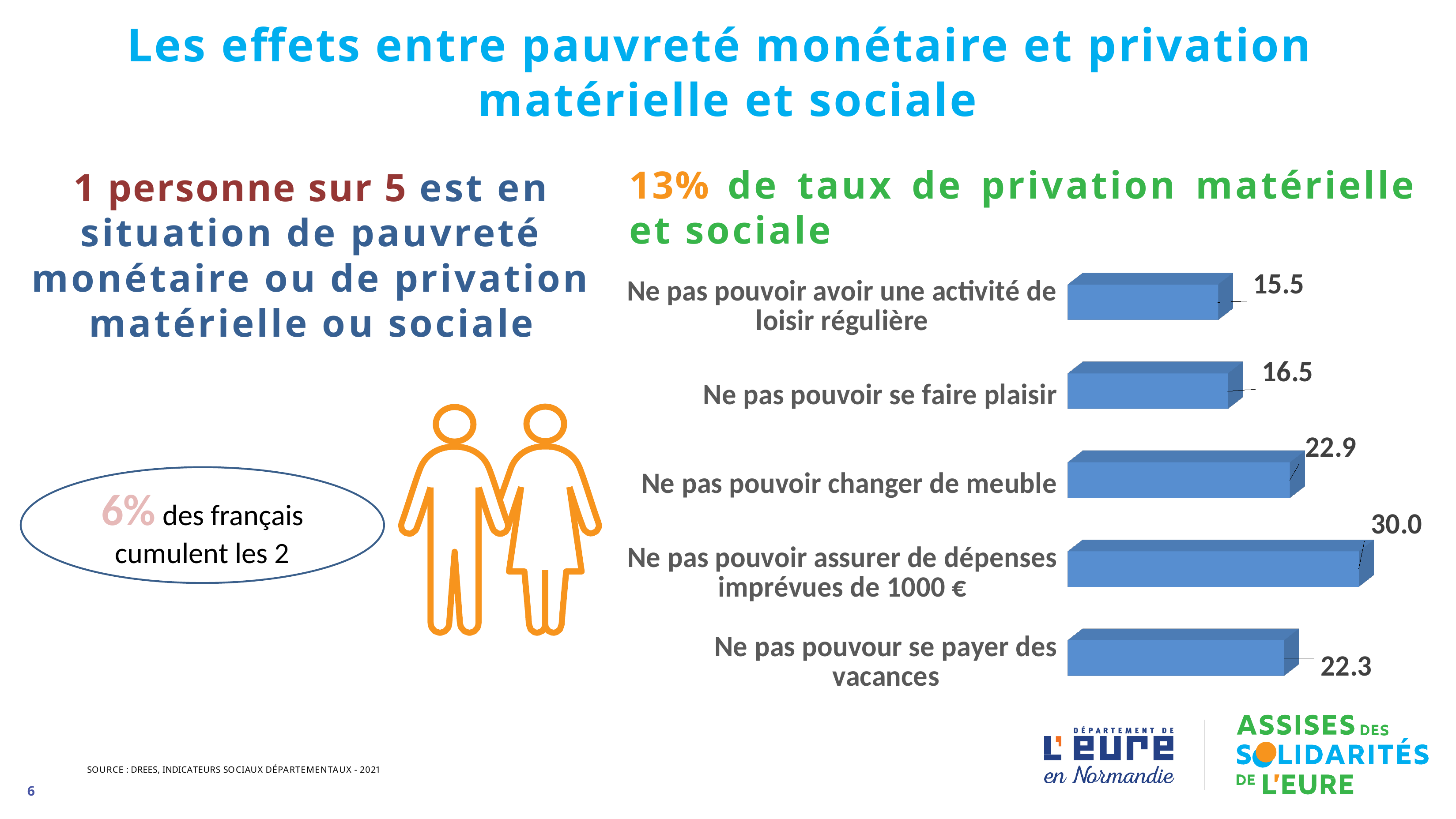
What is the value for "Ne pas pouvoir assurer de dépenses imprévues de 1000 €"? 30.0 Which is larger: the value for "Ne pas pouvoir changer de meuble" or for "Ne pas pouvour se payer des vacances"? Ne pas pouvoir changer de meuble Which category has the highest value? Ne pas pouvoir assurer de dépenses imprévues de 1000 € How many categories does the bar chart show? 5 What is the value for "Ne pas pouvoir changer de meuble"? 22.9 Which category has the lowest value? Ne pas pouvoir avoir une activité de loisir régulière What is the value for "Ne pas pouvoir avoir une activité de loisir régulière"? 15.5 What is the difference between the values for "Ne pas pouvoir assurer de dépenses imprévues de 1000 €" and "Ne pas pouvoir se faire plaisir"? 13.5 What kind of chart is shown on the slide? Bar chart What colour are the bars in the chart? Blue What is the value for "Ne pas pouvour se payer des vacances"? 22.3 What is the value for "Ne pas pouvoir se faire plaisir"? 16.5